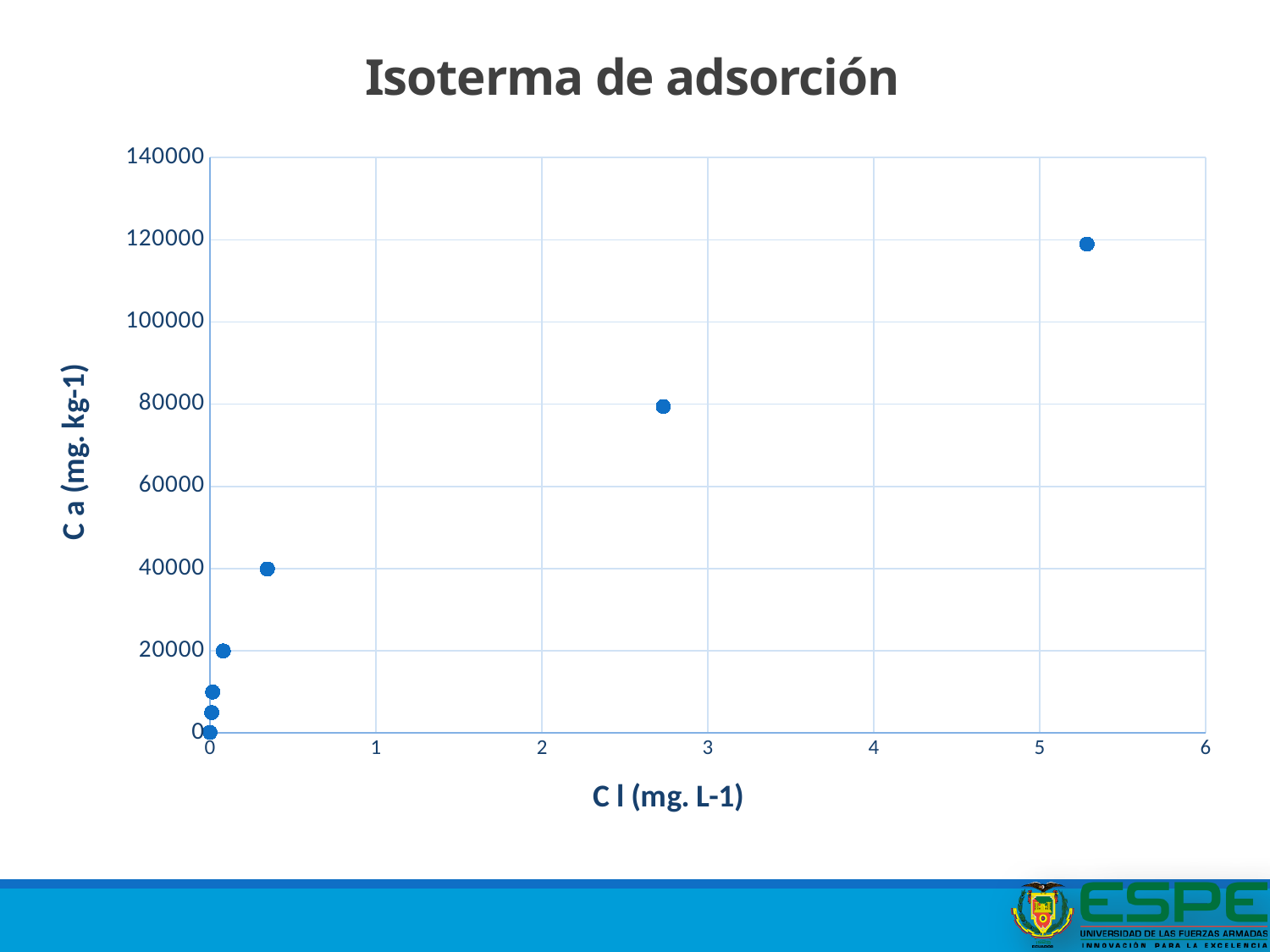
Is the value of C a for the point near C l = 0.3 greater or less than 20000? greater What is the label of the vertical axis? C a (mg. kg-1) What is the maximum value shown on the vertical axis? 140000 Which has the higher C a value: the point near C l = 2.7 or the point near C l = 5.3? The point near C l = 5.3 Is the value of C a for the point near C l = 2.7 greater or less than 100000? less What is the title of the chart? Isoterma de adsorción Is the value of C a for the point with the largest C l (near 5.3) greater or less than 100000? greater How many data points are plotted on the chart? 7 Do the plotted values rise or fall as C l increases along the x axis? Rise What kind of chart is shown on the slide? Scatter chart